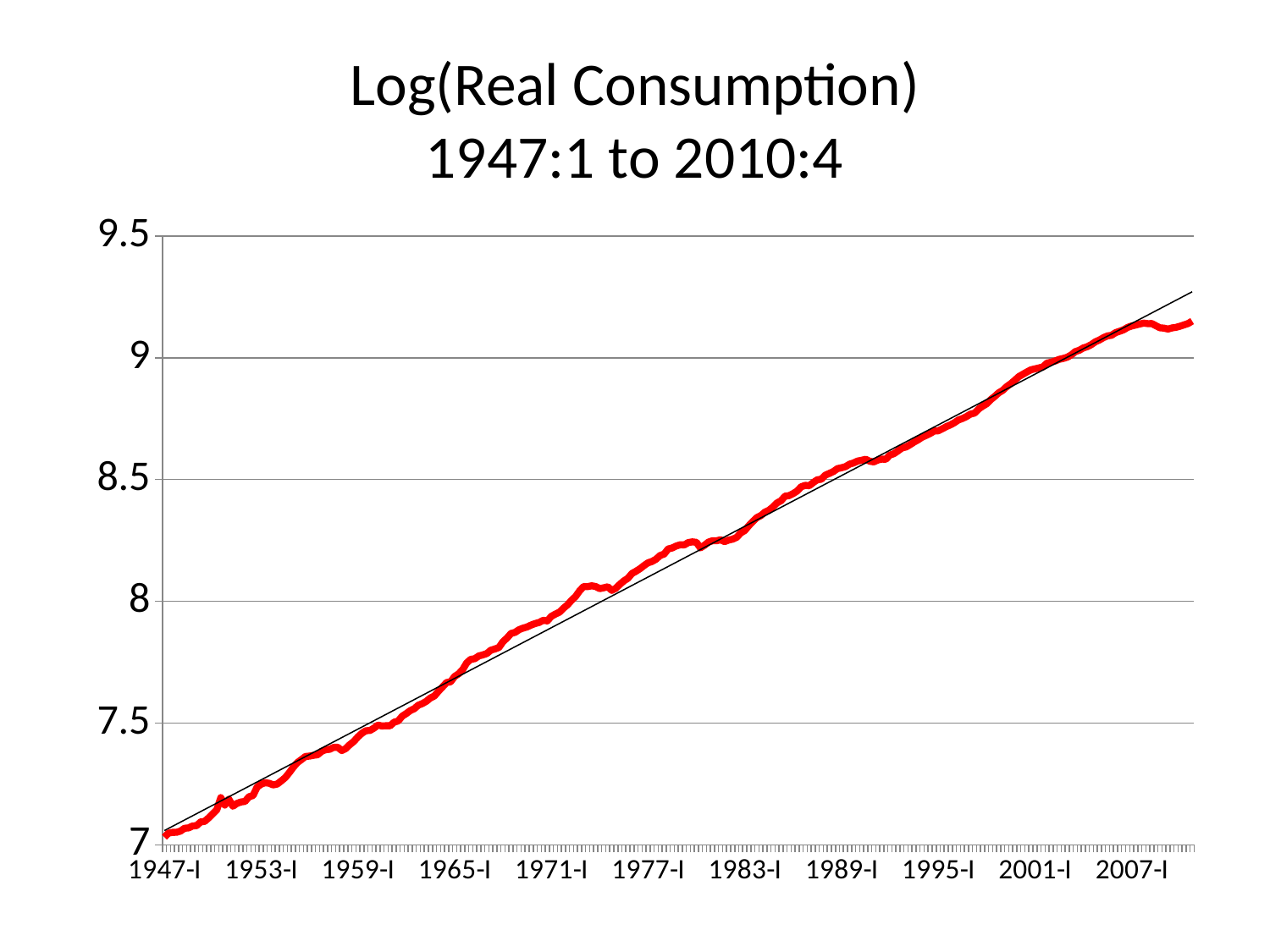
Is the value of the red line at 1977-I greater or less than 8? greater Is the value of the red line at 2007-I greater or less than 9? greater Which has the larger value on the red line, 1947-I or 2007-I? 2007-I What is the title of the chart? Log(Real Consumption) 1947:1 to 2010:4 What is the highest value shown on the y axis? 9.5 Is the value of the red line at 1947-I greater or less than 7.5? less What kind of chart is shown on the slide? line chart How many year labels are shown on the x axis? 11 What colour is the thick data line in the chart? red Do the values of the red line generally rise or fall from 1947-I to 2007-I? rise